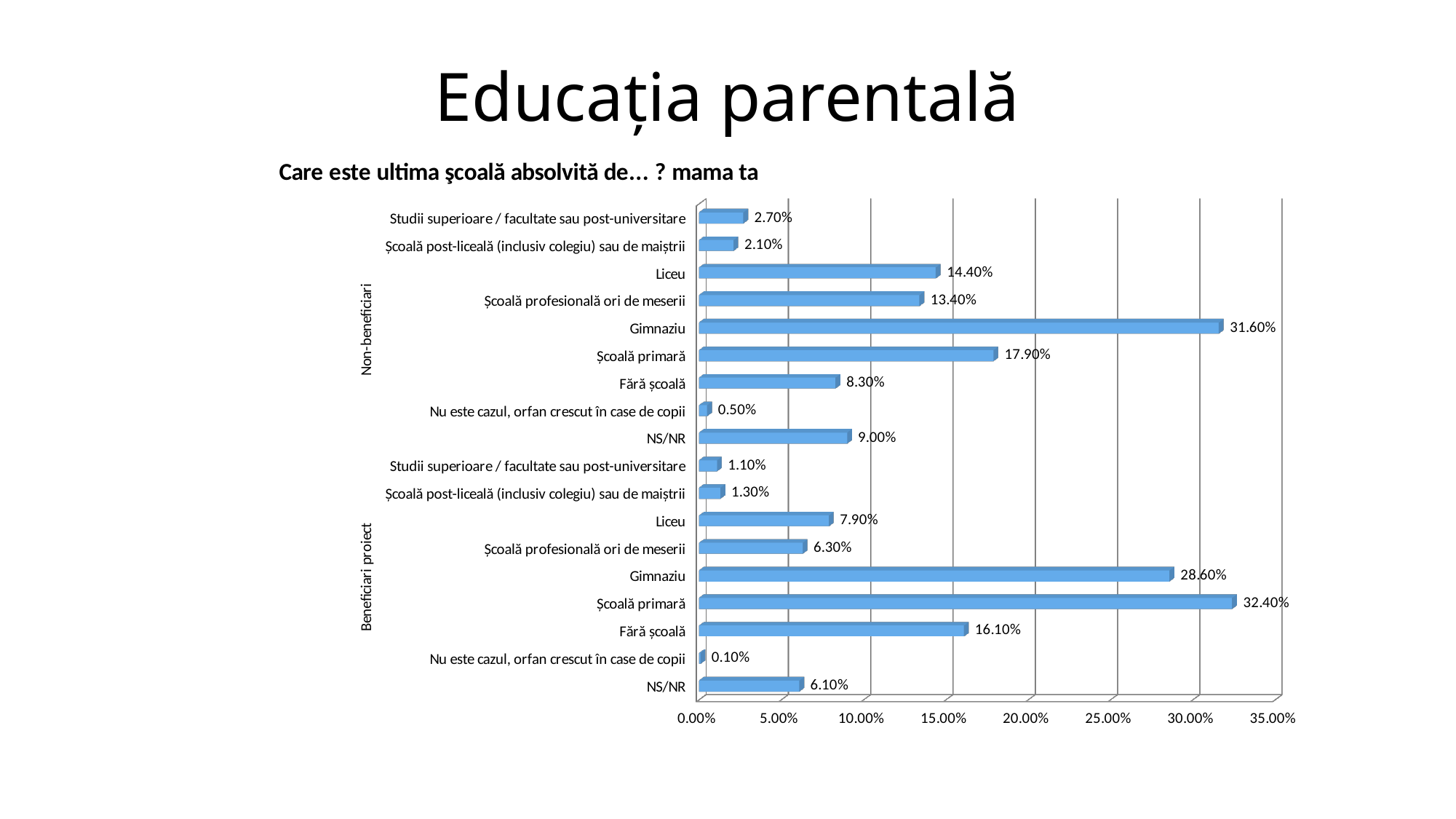
What is the value for Gimnaziu in the Non-beneficiari group? 31.60% What is the title of the chart? Care este ultima școală absolvită de... ? mama ta What is the value for Fără școală in the Beneficiari proiect group? 16.10% How many bars are plotted in the chart? 18 Which category has the highest value in the Beneficiari proiect group? Școală primară What is the value for Școală primară in the Beneficiari proiect group? 32.40% Is the value for Școală primară in the Non-beneficiari group greater or less than 15.00%? greater What kind of chart is shown on the slide? Bar chart Which category has the lowest value in the Non-beneficiari group? Nu este cazul, orfan crescut în case de copii Which is larger: Gimnaziu for Non-beneficiari or Gimnaziu for Beneficiari proiect? Gimnaziu for Non-beneficiari What is the value for NS/NR in the Non-beneficiari group? 9.00% What is the difference between Liceu in the Non-beneficiari group and Liceu in the Beneficiari proiect group? 6.50%